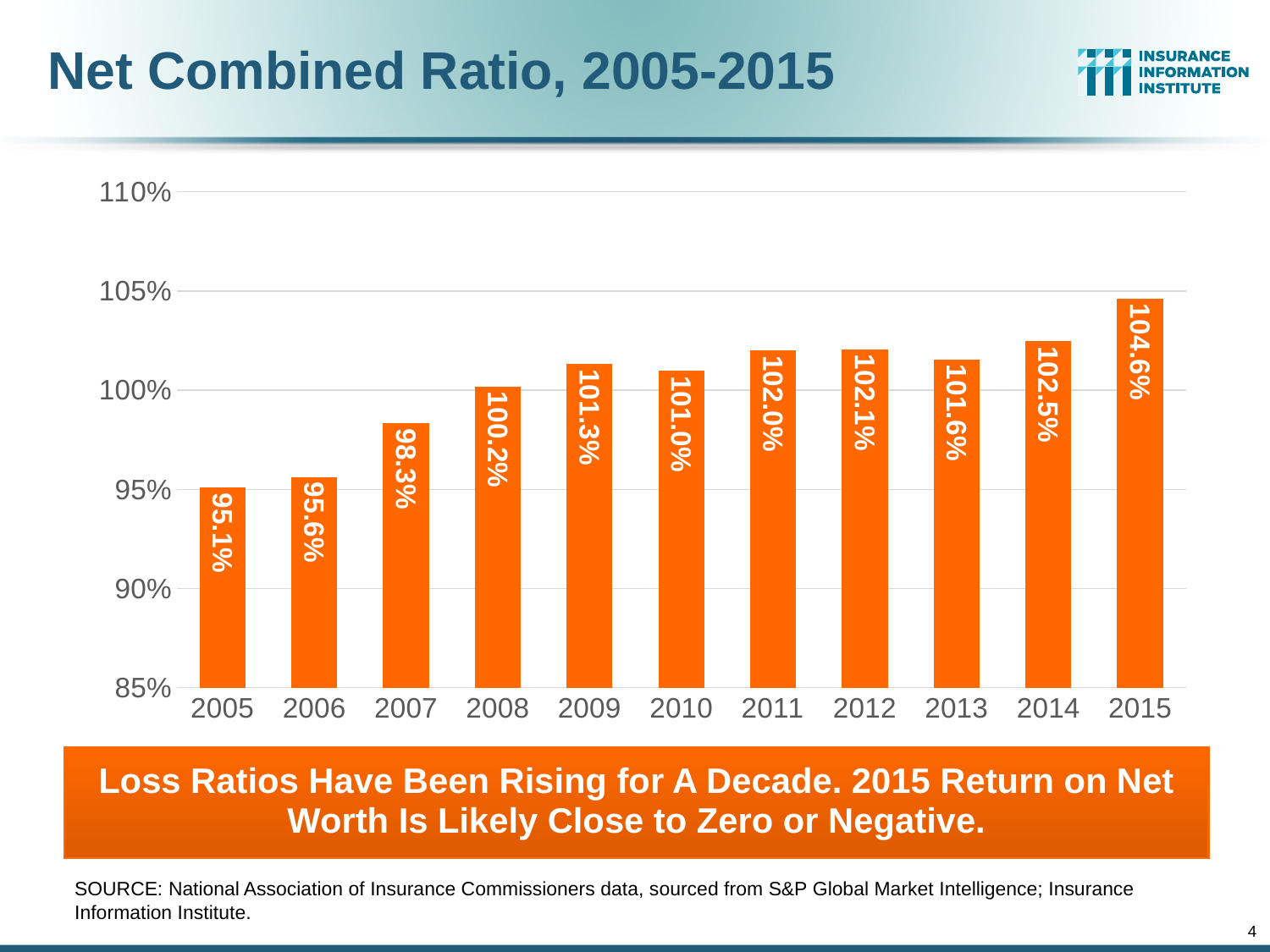
Which year has the larger net combined ratio, 2009 or 2010? 2009 What is the difference between the net combined ratio in 2014 and in 2013? 0.9 percentage points How many years are shown on the chart? 11 Which year has the highest net combined ratio? 2015 What is the title of the chart? Net Combined Ratio, 2005-2015 What is the difference between the net combined ratio in 2015 and in 2005? 9.5 percentage points Which year has the lowest net combined ratio? 2005 Is the value for 2007 greater or less than 100%? less What is the net combined ratio for 2013? 101.6% What kind of chart is shown on the slide? Bar chart What is the net combined ratio for 2008? 100.2% Do the net combined ratio values generally rise or fall from 2005 to 2015? Rise